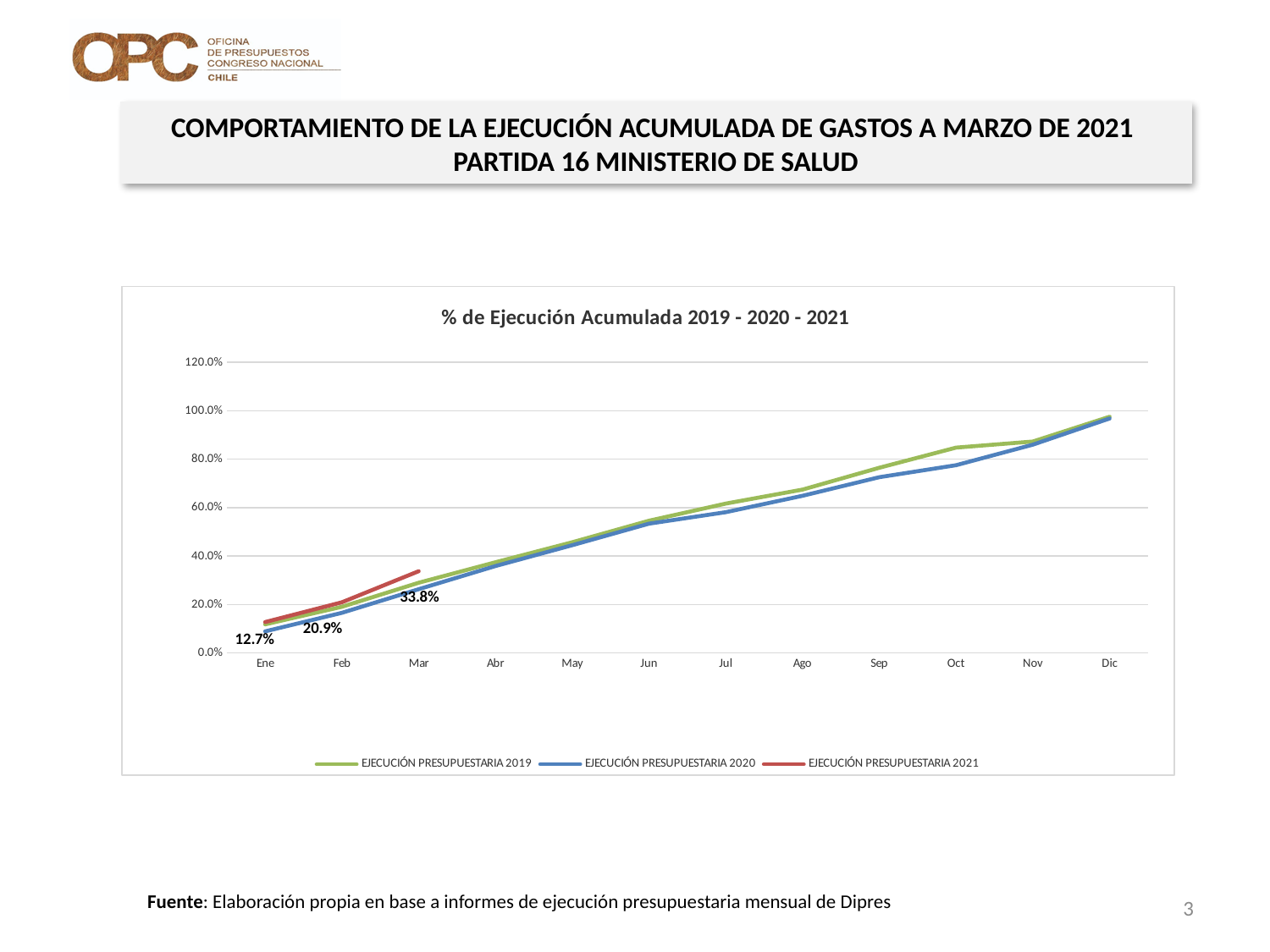
What is the value for EJECUCIÓN PRESUPUESTARIA 2021 in Mar? 33.8% Do the values for EJECUCIÓN PRESUPUESTARIA 2019 rise or fall from Ene to Dic? Rise What is the title of the chart? % de Ejecución Acumulada 2019 - 2020 - 2021 What kind of chart is shown on the slide? Line chart What is the value for EJECUCIÓN PRESUPUESTARIA 2021 in Feb? 20.9% What is the value for EJECUCIÓN PRESUPUESTARIA 2021 in Ene? 12.7% Is the value for EJECUCIÓN PRESUPUESTARIA 2019 in Oct greater or less than 80.0%? greater In Mar, which series has the higher value: EJECUCIÓN PRESUPUESTARIA 2021 or EJECUCIÓN PRESUPUESTARIA 2020? EJECUCIÓN PRESUPUESTARIA 2021 How many months are shown on the x axis? 12 By how many percentage points did EJECUCIÓN PRESUPUESTARIA 2021 increase from Feb to Mar? 12.9% How many series does the legend list? 3 What is the difference between the Mar and Ene values for EJECUCIÓN PRESUPUESTARIA 2021? 21.1%